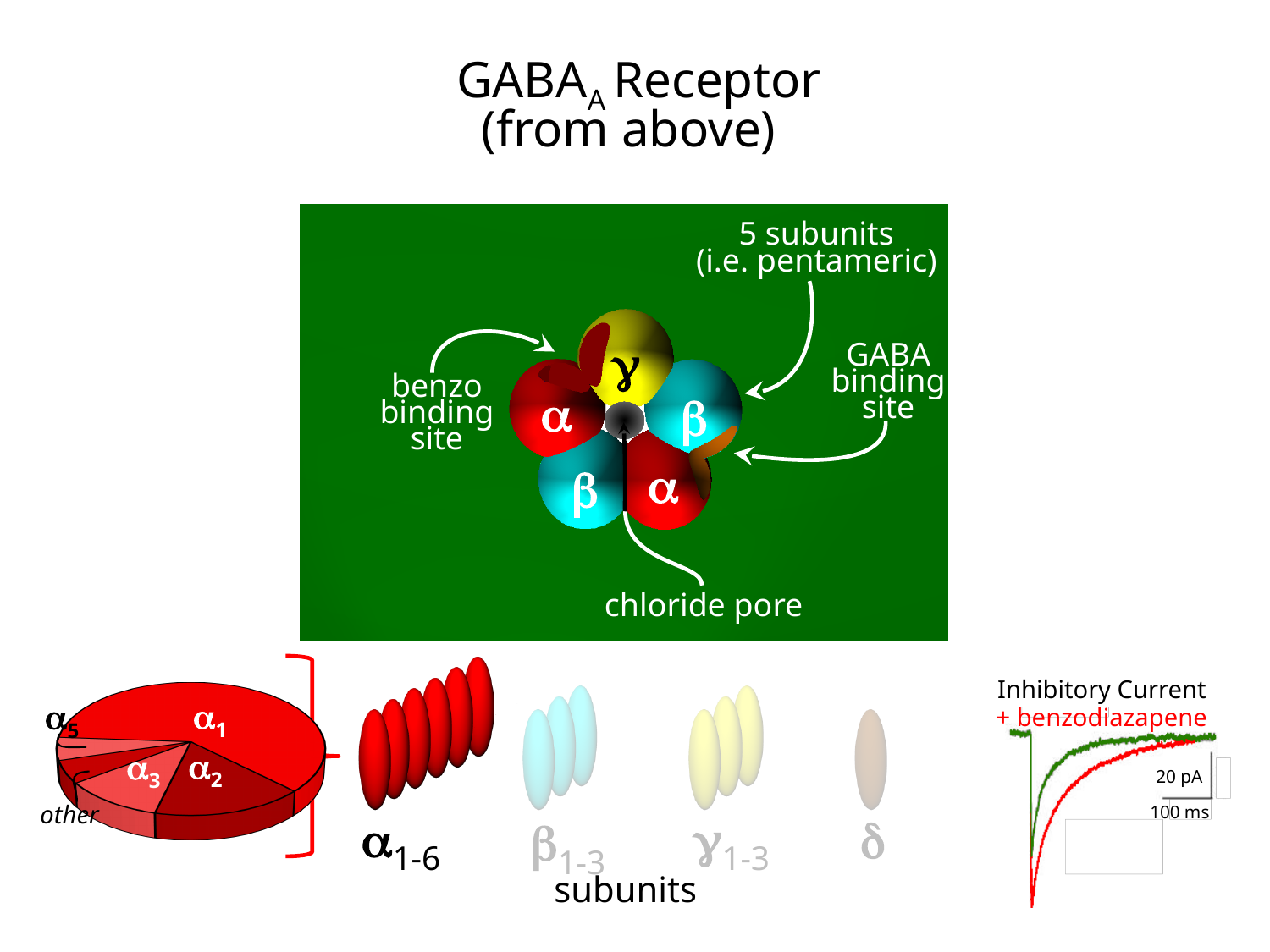
In the pie chart at the bottom left, which slice is larger, α3 or α1? α1 Which slice of the pie chart at the bottom left is labelled in italics rather than with a Greek letter? other In the Inhibitory Current trace at the bottom right, what colour is the trace labelled '+ benzodiazapene'? red How many slices does the pie chart at the bottom left have? 5 What kind of chart is shown at the bottom left of the slide? pie chart Which slice of the pie chart at the bottom left is the largest? α1 In the pie chart at the bottom left, does the α1 slice take up more or less than half of the pie? more In the pie chart at the bottom left, which slice is larger, α1 or α2? α1 In the pie chart at the bottom left, which slice is larger, α2 or α5? α2 How many traces are plotted in the Inhibitory Current graph at the bottom right? 2